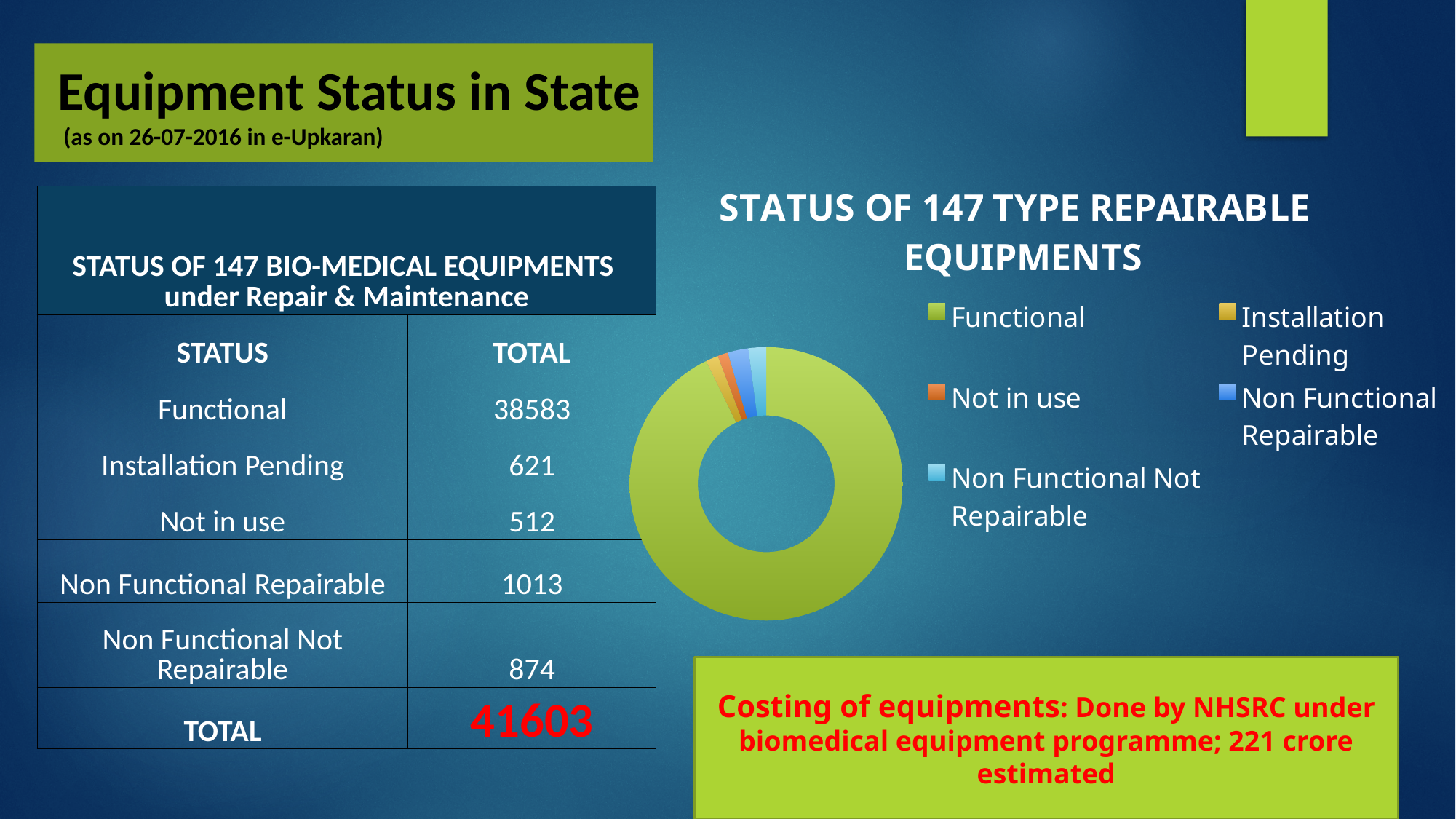
According to the slide, what is the total for Functional equipment? 38583 Which colour represents Functional in the chart? Green According to the slide, what is the total for Non Functional Not Repairable equipment? 874 What is the title of the chart? STATUS OF 147 TYPE REPAIRABLE EQUIPMENTS How many categories does the chart's legend list? 5 According to the slide, what is the total for Non Functional Repairable equipment? 1013 According to the slide, what is the overall total of the 147 bio-medical equipments? 41603 What kind of chart is shown on the slide? Doughnut (pie) chart Does the Functional slice take up more or less than half of the chart? More Which is larger in the chart, the Functional slice or the Non Functional Repairable slice? Functional Which category has the largest slice in the chart? Functional What is the difference between the Installation Pending total and the Not in use total shown on the slide? 109